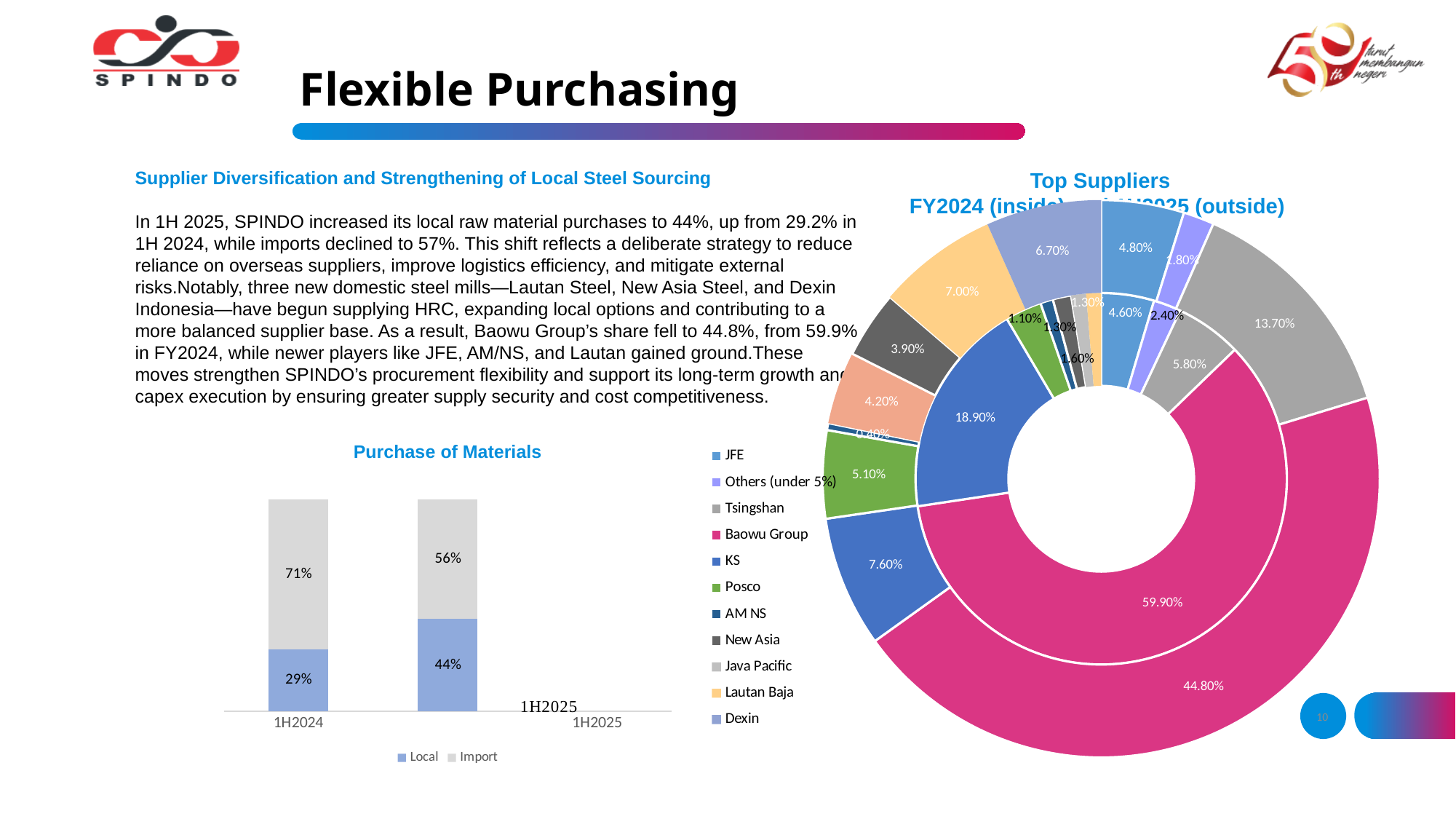
In the Purchase of Materials chart, by how many percentage points did the Local share increase from 1H2024 to 1H2025? 15 percentage points In the Purchase of Materials chart, what is the Local share for 1H2025? 44% In the Purchase of Materials chart, what is the Import share for 1H2025? 56% In the Top Suppliers chart, which supplier has the largest share in the outer ring (1H2025)? Baowu Group In the Purchase of Materials chart, what is the Local share for 1H2024? 29% What kind of chart is the Purchase of Materials chart? Stacked bar chart In the Purchase of Materials chart, what is the Import share for 1H2024? 71% In the Top Suppliers chart, what is Baowu Group's share in the outer ring (1H2025)? 44.80% In the Top Suppliers chart, what is Baowu Group's share in the inside ring (FY2024)? 59.90% How many entries does the legend of the Top Suppliers chart list? 11 How many series does the legend of the Purchase of Materials chart list? 2 In the Top Suppliers chart, what is Tsingshan's share in the outer ring (1H2025)? 13.70%